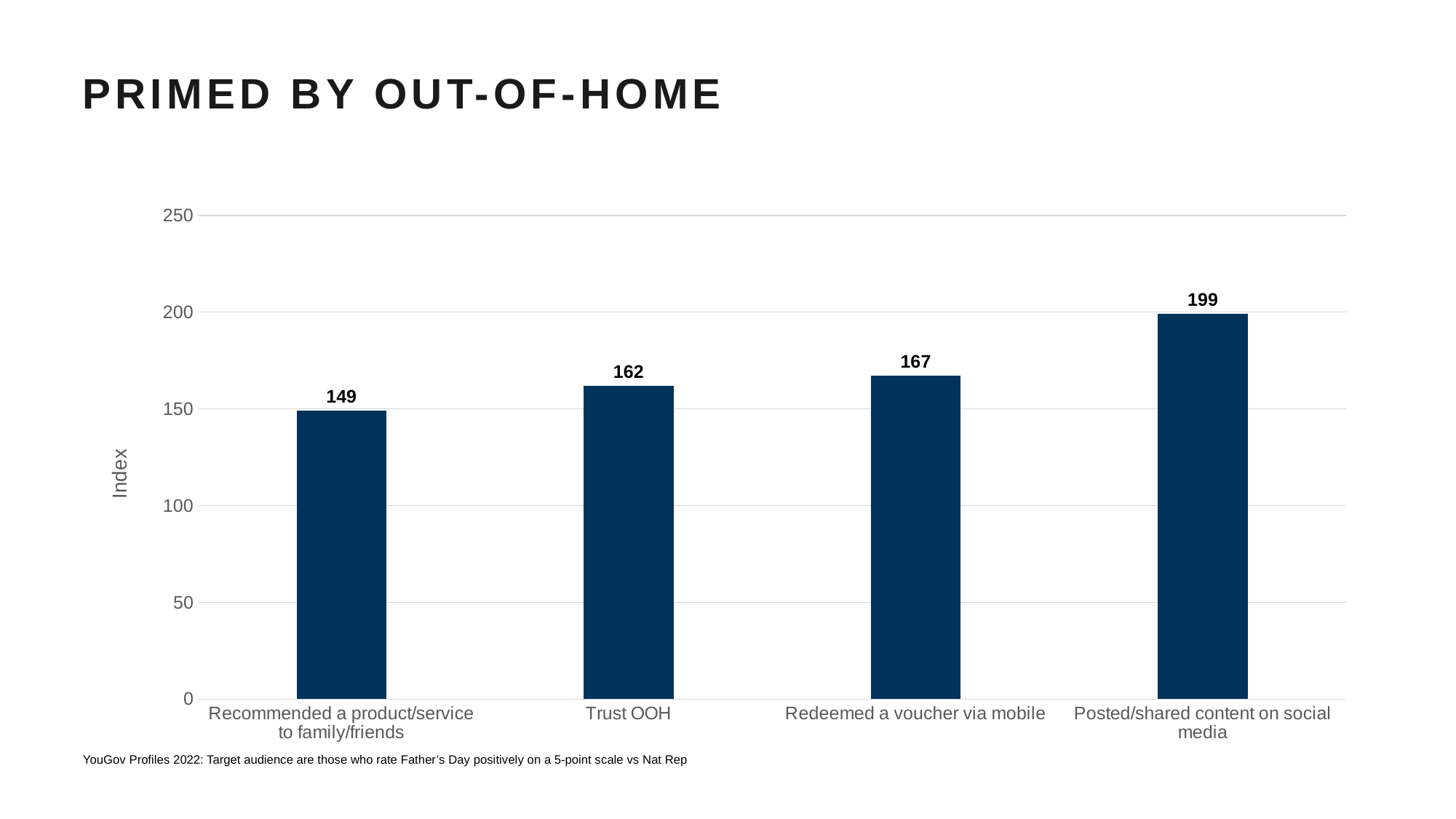
What is the index value for Trust OOH? 162 What is the index value for Recommended a product/service to family/friends? 149 How many categories are shown on the chart? 4 What is the label on the vertical axis of the chart? Index What kind of chart is shown on the slide? Bar chart What is the index value for Redeemed a voucher via mobile? 167 What is the difference between the index values for Posted/shared content on social media and Recommended a product/service to family/friends? 50 Is the index value for Trust OOH greater or less than 150? greater What is the index value for Posted/shared content on social media? 199 Which category has the highest index value? Posted/shared content on social media Which category has the lowest index value? Recommended a product/service to family/friends Which has a higher index value, Trust OOH or Redeemed a voucher via mobile? Redeemed a voucher via mobile